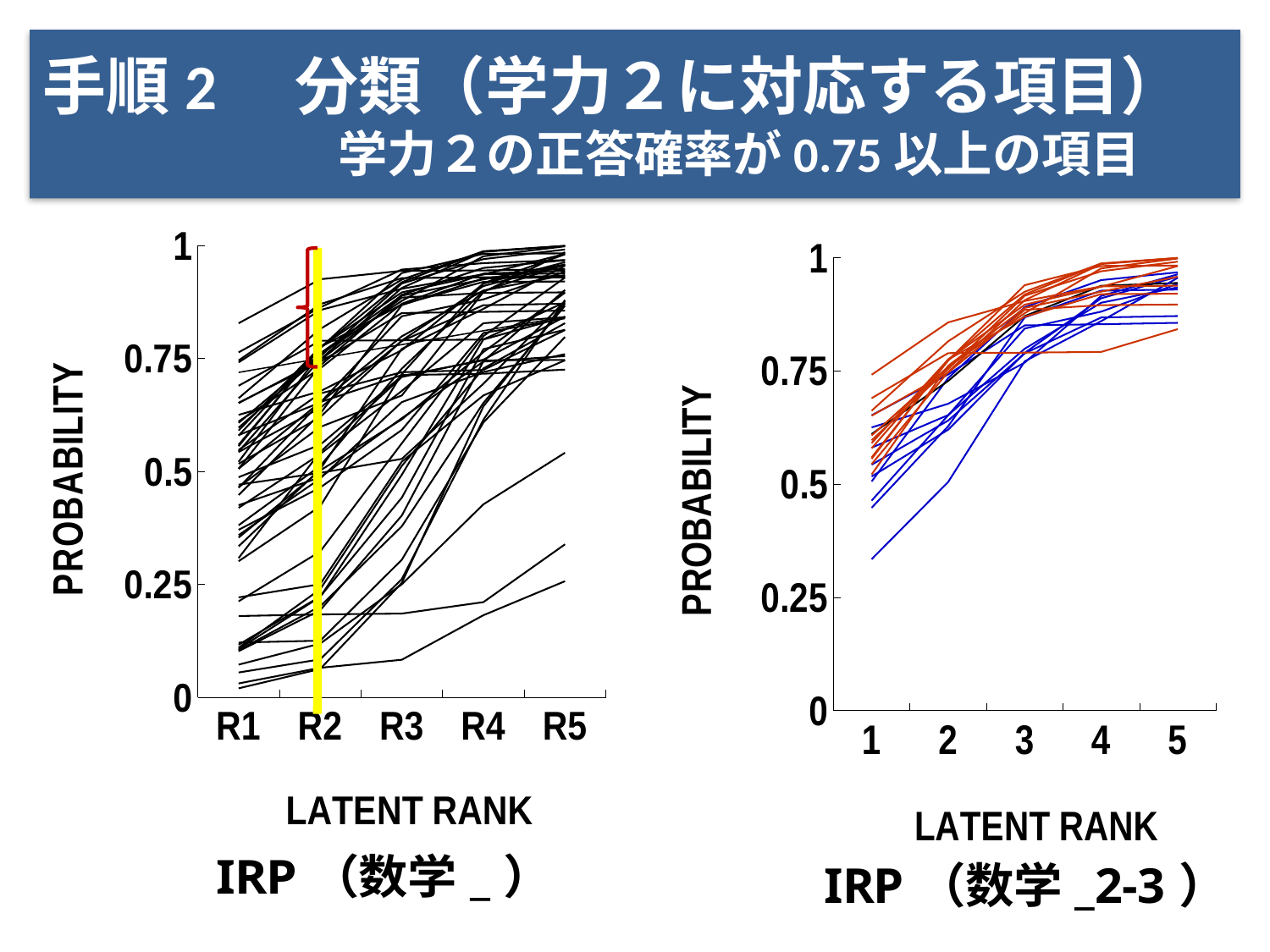
What kind of chart is the right chart titled IRP (数学_2-3)? line chart What kind of chart is the left chart titled IRP (数学_)? line chart What is the label of the x axis on the right chart? LATENT RANK In the left chart, at which latent rank is the yellow vertical line drawn? R2 What is the highest tick value shown on the y axis of the right chart? 1 In the right chart, is the lowest blue line's value at latent rank 1 greater or less than 0.5? less In the right chart, do the lines generally rise or fall as latent rank increases from 1 to 5? rise In the left chart, do the lines generally rise or fall from R1 to R5? rise How many latent rank categories are shown on the x axis of the right chart? 5 How many latent rank categories are shown on the x axis of the left chart? 5 In the right chart, is the highest red line's value at latent rank 5 greater or less than 0.75? greater